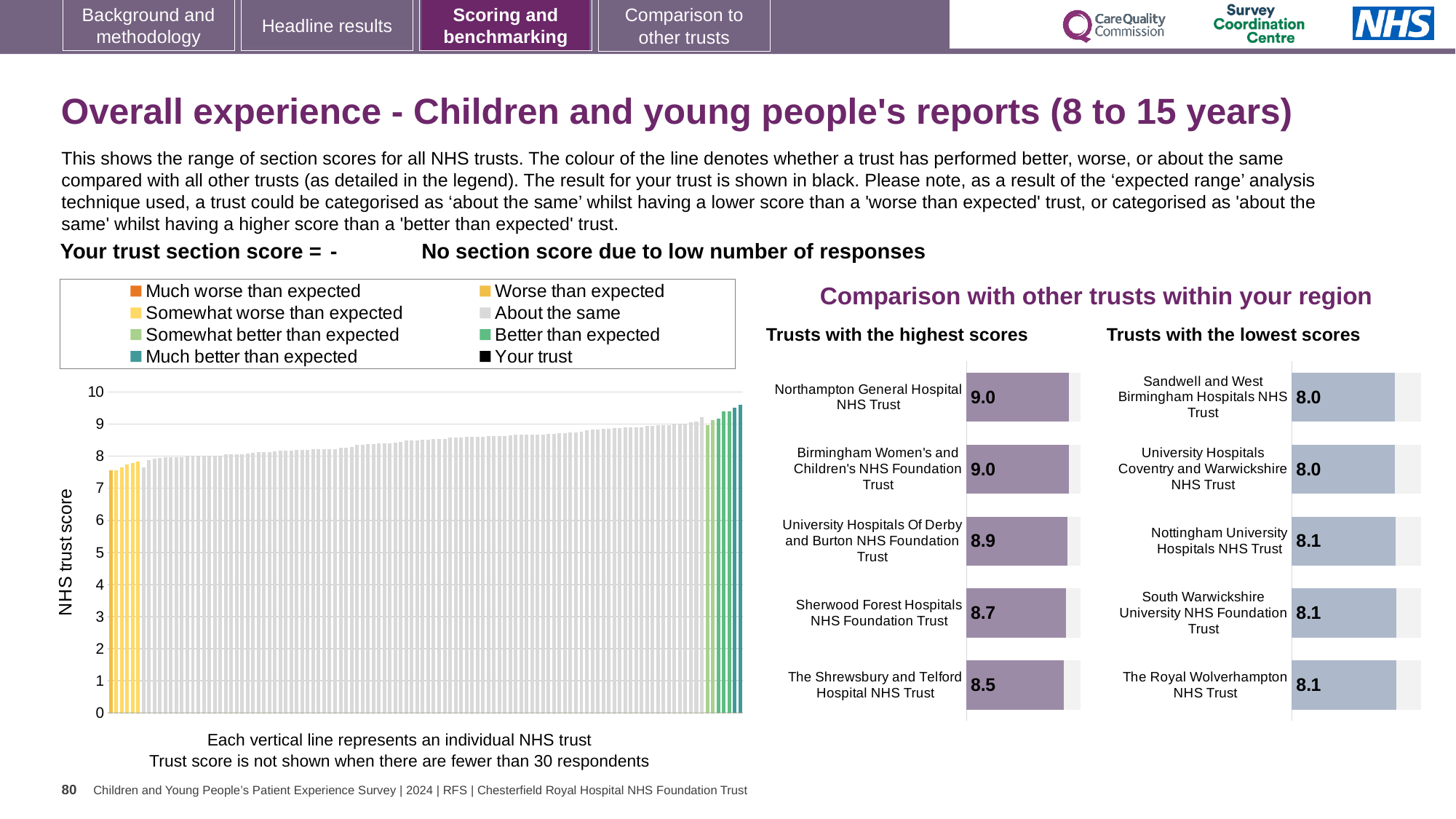
In the main 'NHS trust score' chart on the left, do the trust scores rise or fall from left to right? Rise In the 'Trusts with the highest scores' chart, what is the score for Sherwood Forest Hospitals NHS Foundation Trust? 8.7 In the main 'NHS trust score' chart on the left, what kind of chart is it? Bar chart How many entries does the legend of the main 'NHS trust score' chart list? 8 In the 'Trusts with the highest scores' chart, what is the difference between the scores of University Hospitals Of Derby and Burton NHS Foundation Trust and The Shrewsbury and Telford Hospital NHS Trust? 0.4 In the 'Trusts with the highest scores' chart, what is the score for Northampton General Hospital NHS Trust? 9.0 In the 'Trusts with the lowest scores' chart, what is the score for Sandwell and West Birmingham Hospitals NHS Trust? 8.0 In the 'Trusts with the highest scores' chart, what is the difference between the scores of Northampton General Hospital NHS Trust and Sherwood Forest Hospitals NHS Foundation Trust? 0.3 In the 'Trusts with the lowest scores' chart, what is the score for The Royal Wolverhampton NHS Trust? 8.1 Which is larger: the score for Sherwood Forest Hospitals NHS Foundation Trust in the 'highest scores' chart or the score for Nottingham University Hospitals NHS Trust in the 'lowest scores' chart? Sherwood Forest Hospitals NHS Foundation Trust In the 'Trusts with the lowest scores' chart, how many trusts are shown? 5 In the 'Trusts with the highest scores' chart, which trust has the lowest score? The Shrewsbury and Telford Hospital NHS Trust